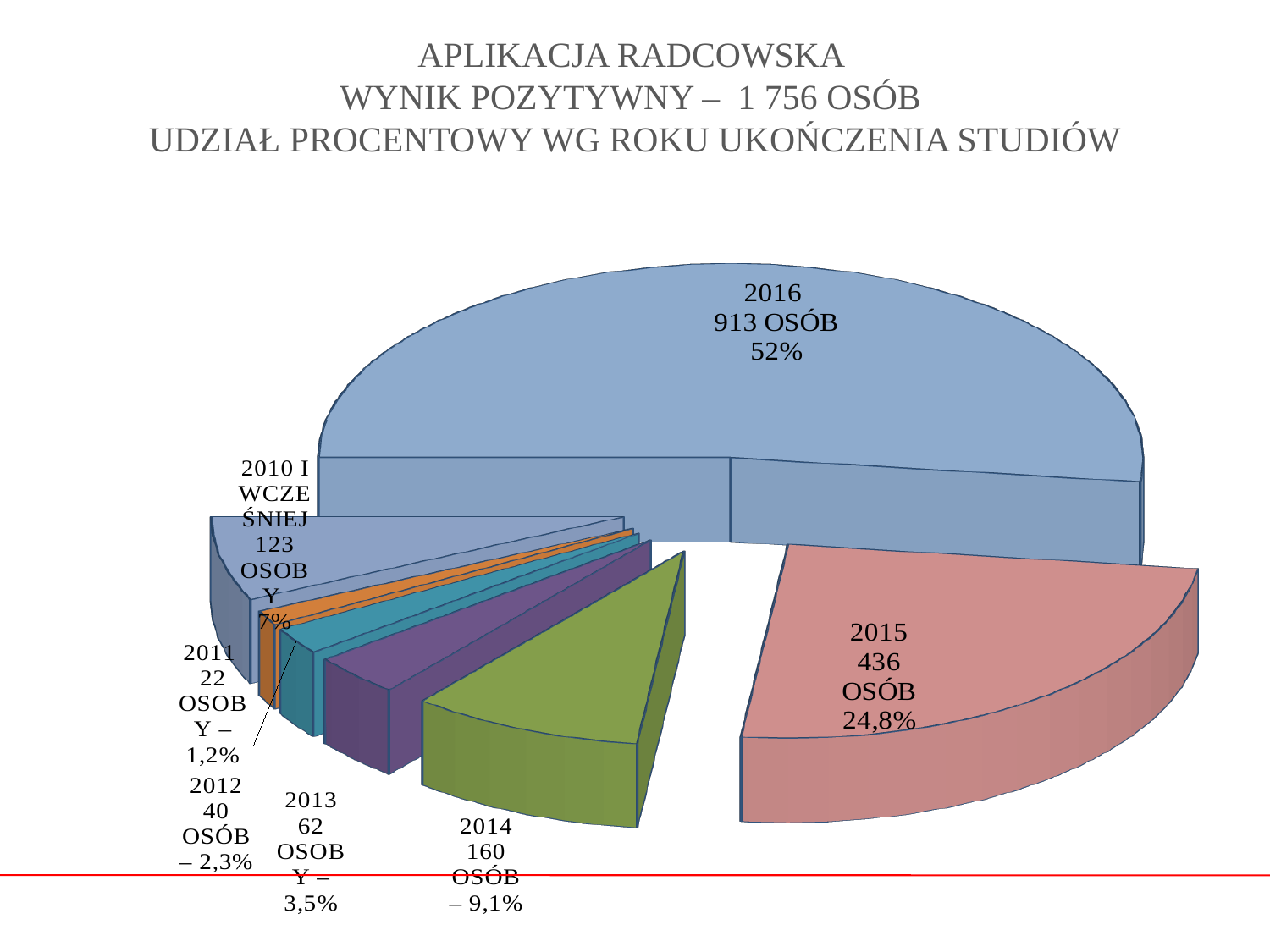
What percentage share is shown for the 2013 slice? 3,5% How many people are shown for the 2014 slice? 160 OSÓB How many people are shown for the 2012 slice? 40 OSÓB What type of chart is shown on the slide? pie chart How many slices does the pie chart have? 7 What percentage share is shown for the '2010 I WCZEŚNIEJ' slice? 7% What is the difference in the number of people between the 2016 and 2015 slices? 477 Which year has the smallest slice of the pie? 2011 Which year has the largest slice of the pie? 2016 Which slice is larger, 2014 or 2013? 2014 What percentage share is shown for the 2015 slice? 24,8% How many people (osób) are shown for the 2016 slice? 913 OSÓB